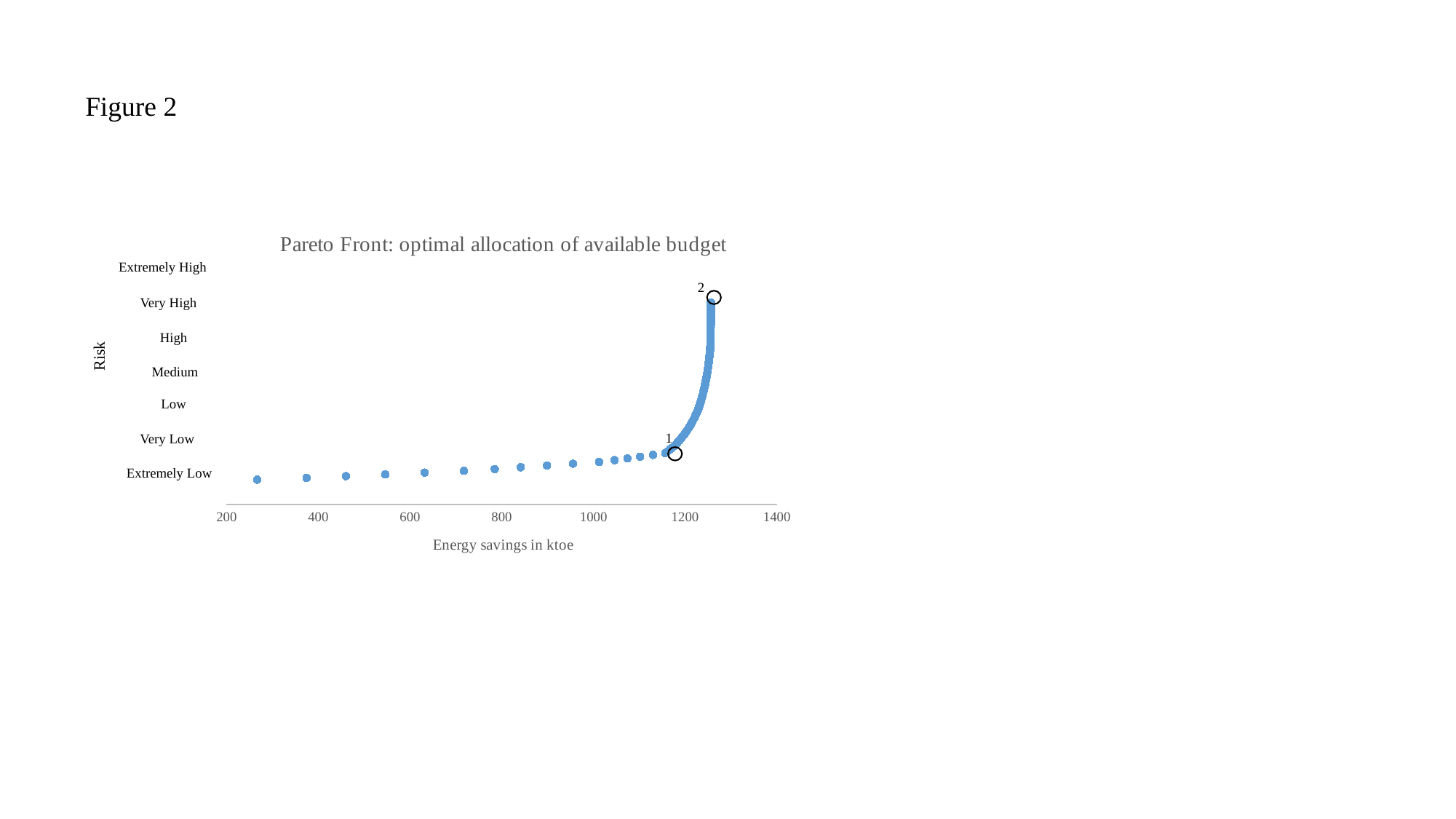
Is the energy savings value for the leftmost point greater or less than 400? less What is the title of the chart? Pareto Front: optimal allocation of available budget What is the label of the x axis? Energy savings in ktoe How many circled, numbered points are marked on the chart? 2 Does risk rise or fall as energy savings increase along the x axis? Rises Which circled point has the higher risk level, point 1 or point 2? Point 2 Is the energy savings value for circled point 2 greater or less than 1200? greater What is the highest risk level labelled on the y axis? Extremely High What kind of chart is shown on the slide? Scatter chart How many risk levels are labelled on the y axis? 7 Which circled point has the higher energy savings, point 1 or point 2? Point 2 Is the energy savings value for the leftmost point greater or less than 200? greater